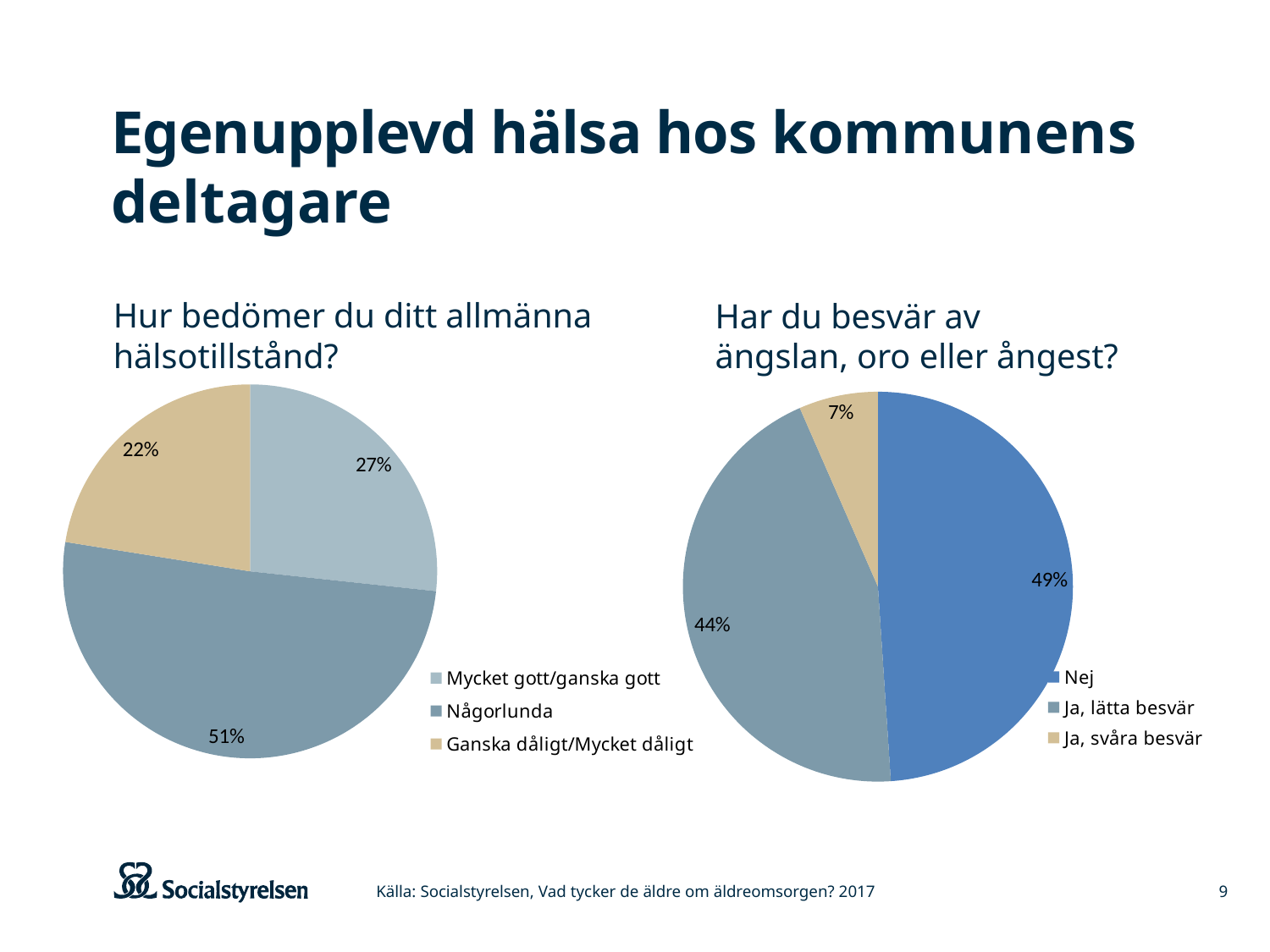
In the left chart (Hur bedömer du ditt allmänna hälsotillstånd?), what share of respondents answered Mycket gott/ganska gott? 27% In the left chart (Hur bedömer du ditt allmänna hälsotillstånd?), what share of respondents answered Någorlunda? 51% In the right chart (Har du besvär av ängslan, oro eller ångest?), what share of respondents answered Nej? 49% In the right chart (Har du besvär av ängslan, oro eller ångest?), which category has the largest slice? Nej In the left chart (Hur bedömer du ditt allmänna hälsotillstånd?), which category has the smallest slice? Ganska dåligt/Mycket dåligt How many categories does the legend of the right chart (Har du besvär av ängslan, oro eller ångest?) list? 3 In the right chart (Har du besvär av ängslan, oro eller ångest?), which is larger: Ja, lätta besvär or Ja, svåra besvär? Ja, lätta besvär In the right chart (Har du besvär av ängslan, oro eller ångest?), what share of respondents answered Ja, svåra besvär? 7% What type of chart is used for the left chart (Hur bedömer du ditt allmänna hälsotillstånd?)? Pie chart In the right chart (Har du besvär av ängslan, oro eller ångest?), what is the difference in percentage points between Nej and Ja, lätta besvär? 5 percentage points In the left chart (Hur bedömer du ditt allmänna hälsotillstånd?), which category has the largest slice? Någorlunda In the left chart (Hur bedömer du ditt allmänna hälsotillstånd?), what is the difference in percentage points between Någorlunda and Ganska dåligt/Mycket dåligt? 29 percentage points